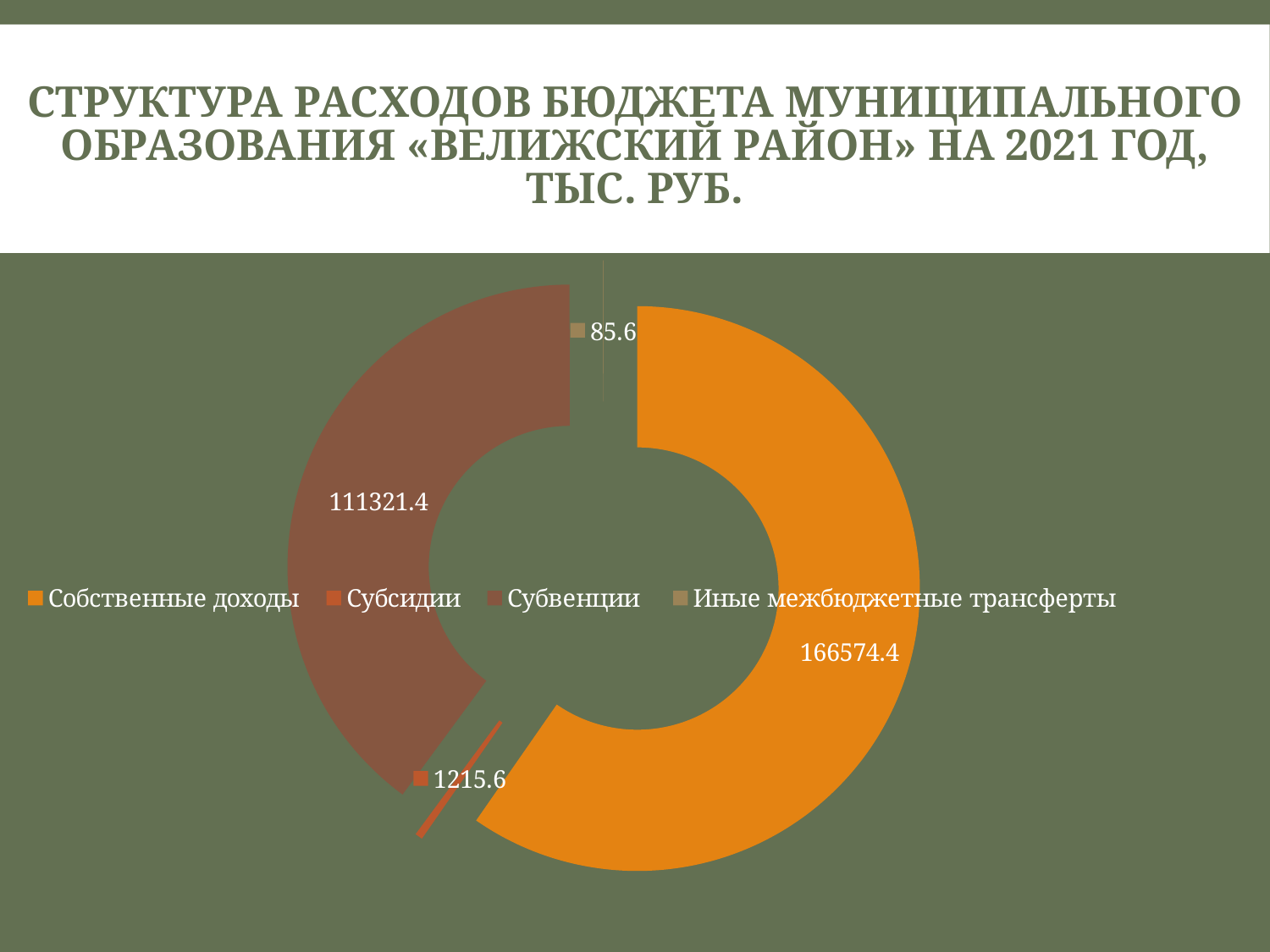
What is the difference between Субсидии and Иные межбюджетные трансферты? 1130.0 Which is larger, Субсидии or Субвенции? Субвенции What is the value for Иные межбюджетные трансферты? 85.6 What is the value for Субвенции? 111321.4 What type of chart is shown on the slide? Doughnut (pie) chart What is the value for Субсидии? 1215.6 What is the value for Собственные доходы? 166574.4 How many categories does the legend list? 4 Which category has the largest value? Собственные доходы Which category has the smallest value? Иные межбюджетные трансферты What colour is the Собственные доходы segment? Orange What is the difference between Собственные доходы and Субвенции? 55253.0